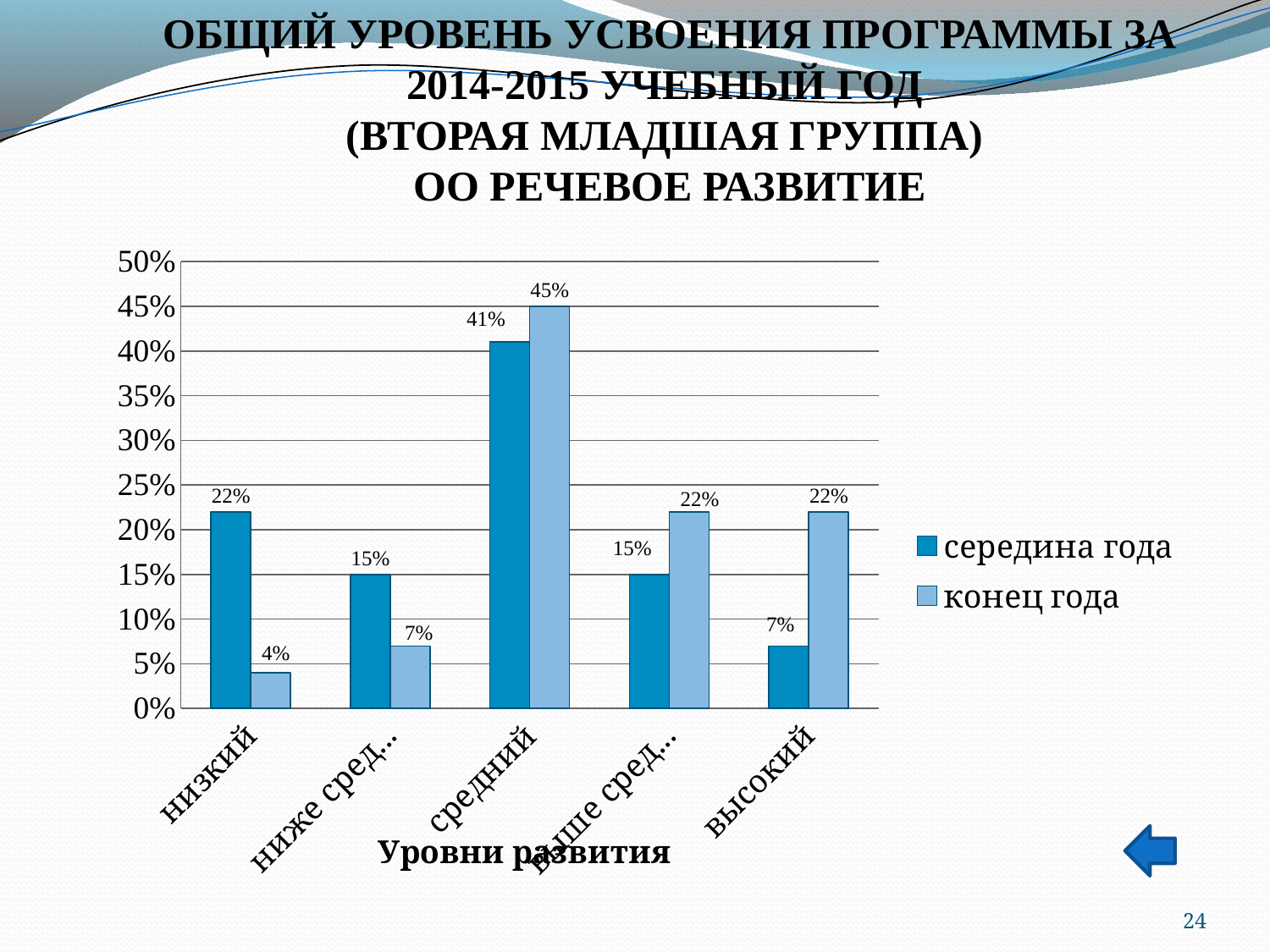
What is the value for 'конец года' in the 'средний' category? 45% What is the x-axis title of the chart? Уровни развития What is the value for 'середина года' in the 'высокий' category? 7% How many series does the legend list? 2 What is the difference between 'конец года' and 'середина года' in the 'высокий' category? 15% In the 'средний' category, which is larger: 'середина года' or 'конец года'? конец года Which category has the highest value for 'конец года'? средний What is the value for 'конец года' in the 'низкий' category? 4% What is the value for 'середина года' in the 'низкий' category? 22% What type of chart is shown on the slide? bar chart Which category has the lowest value for 'конец года'? низкий How many categories are shown on the x axis? 5